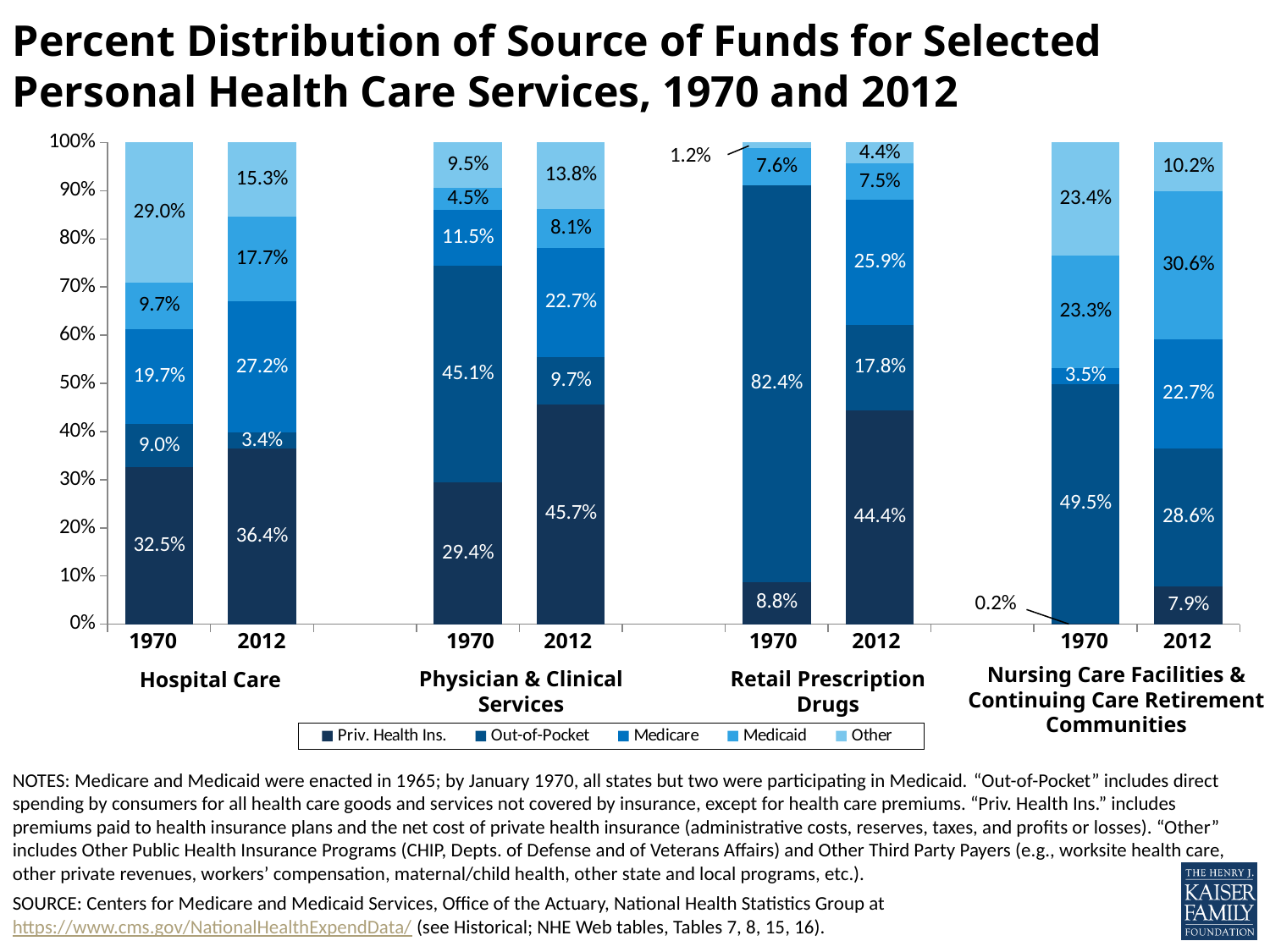
How many bars are plotted in the chart? 8 Which service category had the largest Out-of-Pocket share in 1970? Retail Prescription Drugs What was the Medicare share for Physician & Clinical Services in 2012? 22.7% By how many percentage points did the Out-of-Pocket share for Physician & Clinical Services change from 1970 (45.1%) to 2012 (9.7%)? 35.4 percentage points What was the Medicaid share for Nursing Care Facilities & Continuing Care Retirement Communities in 2012? 30.6% What share of Hospital Care funds came from Private Health Insurance in 1970? 32.5% What was the Out-of-Pocket share for Retail Prescription Drugs in 1970? 82.4% What was the Private Health Insurance share for Nursing Care Facilities & Continuing Care Retirement Communities in 1970? 0.2% What kind of chart is shown on the slide? Stacked bar chart Which was larger for Hospital Care in 2012: the Medicare share or the Medicaid share? Medicare (27.2%) Which legend entry is shown in the lightest blue colour? Other How many series does the legend list? 5